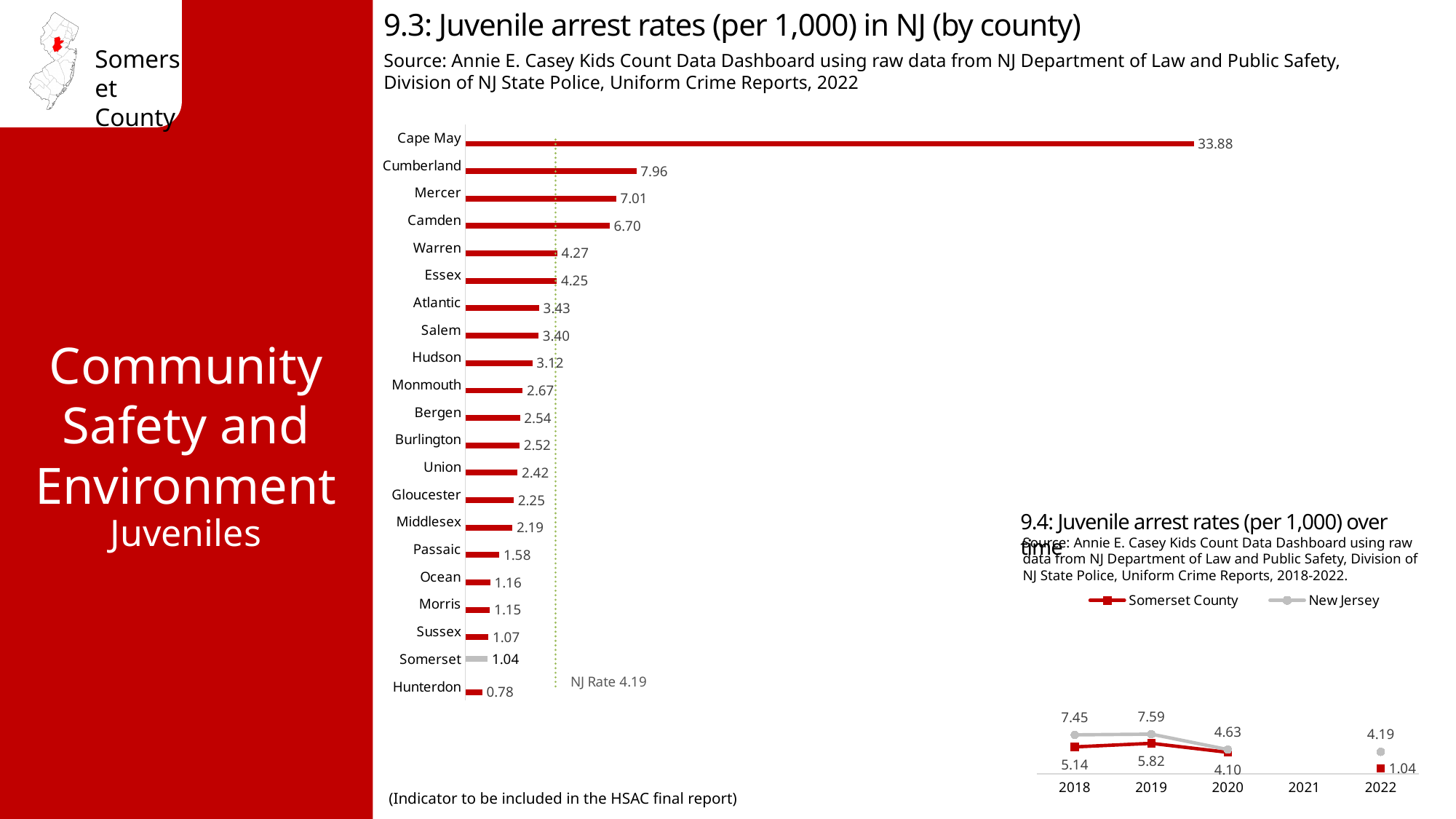
In the chart '9.3: Juvenile arrest rates (per 1,000) in NJ (by county)', which county has the lowest value? Hunterdon What kind of chart is '9.3: Juvenile arrest rates (per 1,000) in NJ (by county)'? Bar chart In the chart '9.3: Juvenile arrest rates (per 1,000) in NJ (by county)', what is the value for Somerset? 1.04 In the chart '9.3: Juvenile arrest rates (per 1,000) in NJ (by county)', what is the value for Cape May? 33.88 In the chart '9.3: Juvenile arrest rates (per 1,000) in NJ (by county)', which county has the highest value? Cape May In the chart '9.3: Juvenile arrest rates (per 1,000) in NJ (by county)', how many counties are shown? 21 In the chart '9.3: Juvenile arrest rates (per 1,000) in NJ (by county)', what is the difference between Cumberland and Mercer? 0.95 In the chart '9.4: Juvenile arrest rates (per 1,000) over time', what is the difference between the New Jersey and Somerset County values in 2022? 3.15 In the chart '9.4: Juvenile arrest rates (per 1,000) over time', what is the Somerset County value for 2019? 5.82 In the chart '9.3: Juvenile arrest rates (per 1,000) in NJ (by county)', what NJ rate is marked by the dotted line? 4.19 In the chart '9.3: Juvenile arrest rates (per 1,000) in NJ (by county)', which is larger, Camden or Warren? Camden In the chart '9.4: Juvenile arrest rates (per 1,000) over time', how many series does the legend list? 2